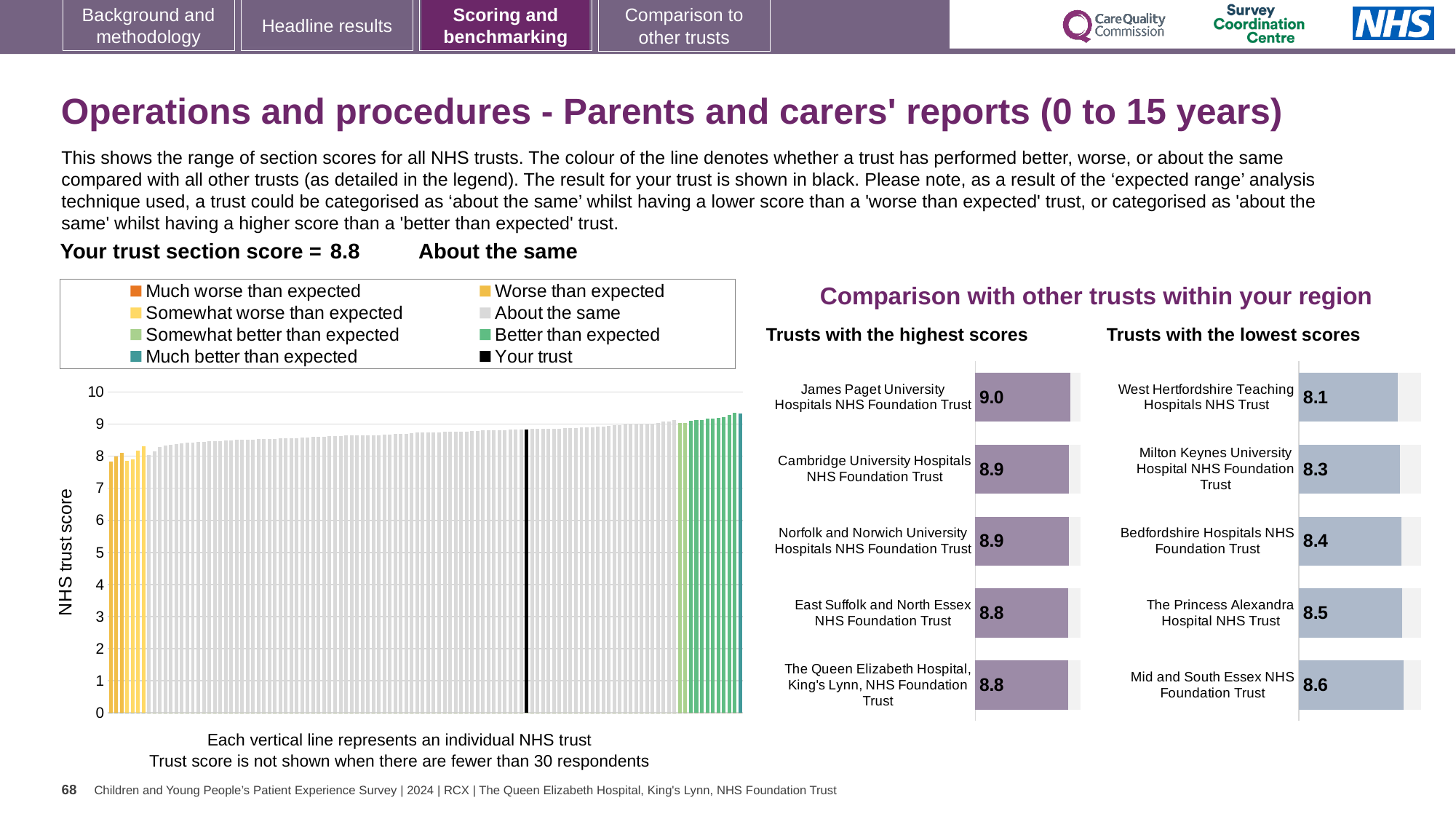
In the 'Trusts with the highest scores' chart, which trust has the highest score? James Paget University Hospitals NHS Foundation Trust In the 'Trusts with the lowest scores' chart, which trust has the lowest score? West Hertfordshire Teaching Hospitals NHS Trust In the 'Trusts with the lowest scores' chart, which trust has the highest score? Mid and South Essex NHS Foundation Trust In the 'Trusts with the lowest scores' chart, what is the difference between the scores of Mid and South Essex NHS Foundation Trust and West Hertfordshire Teaching Hospitals NHS Trust? 0.5 In the 'Trusts with the lowest scores' chart, which has the larger score: Milton Keynes University Hospital NHS Foundation Trust or The Princess Alexandra Hospital NHS Trust? The Princess Alexandra Hospital NHS Trust In the large chart on the left, how many entries does the legend list? 8 In the 'Trusts with the lowest scores' chart, what is the score for West Hertfordshire Teaching Hospitals NHS Trust? 8.1 In the 'Trusts with the highest scores' chart, what is the score for James Paget University Hospitals NHS Foundation Trust? 9.0 In the 'Trusts with the highest scores' chart, what is the difference between the scores of James Paget University Hospitals NHS Foundation Trust and East Suffolk and North Essex NHS Foundation Trust? 0.2 In the large chart on the left showing NHS trust scores, what kind of chart is it? Bar chart In the 'Trusts with the highest scores' chart, how many trusts are listed? 5 In the 'Trusts with the highest scores' chart, what is the score for The Queen Elizabeth Hospital, King's Lynn, NHS Foundation Trust? 8.8